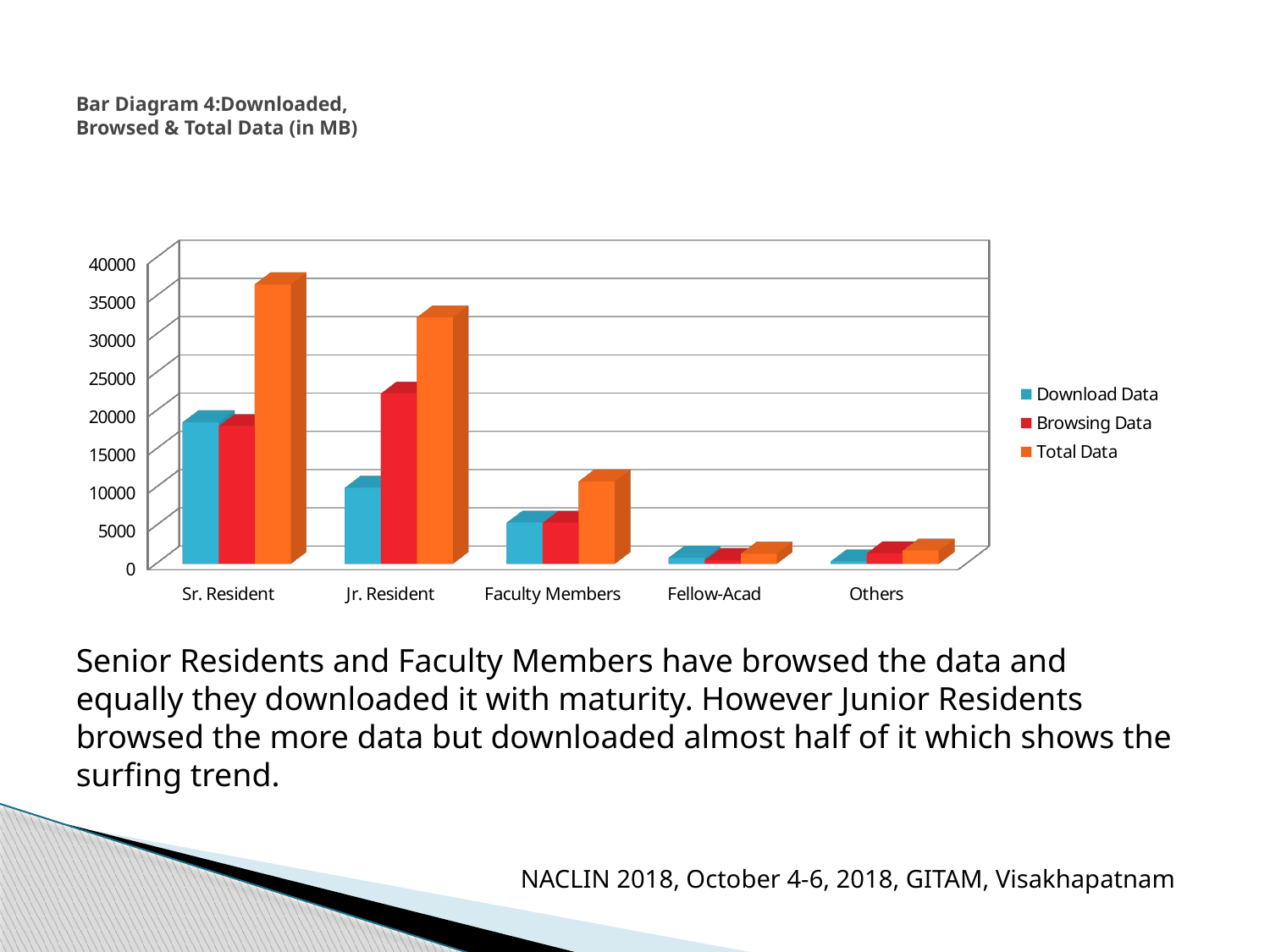
What colour represents the Total Data series in the chart? Orange Which category has the highest Total Data value? Sr. Resident Is the Total Data value for Jr. Resident greater or less than 30000? greater Is the Download Data value for Jr. Resident greater or less than 15000? less How many categories are shown on the x axis of the chart? 5 For Jr. Resident, which is larger: Download Data or Browsing Data? Browsing Data Is the Total Data value for Sr. Resident greater or less than 35000? greater Which category has a larger Total Data value: Jr. Resident or Faculty Members? Jr. Resident How many series does the chart's legend list? 3 What kind of chart is shown on the slide? Bar chart Which category has the highest Browsing Data value? Jr. Resident